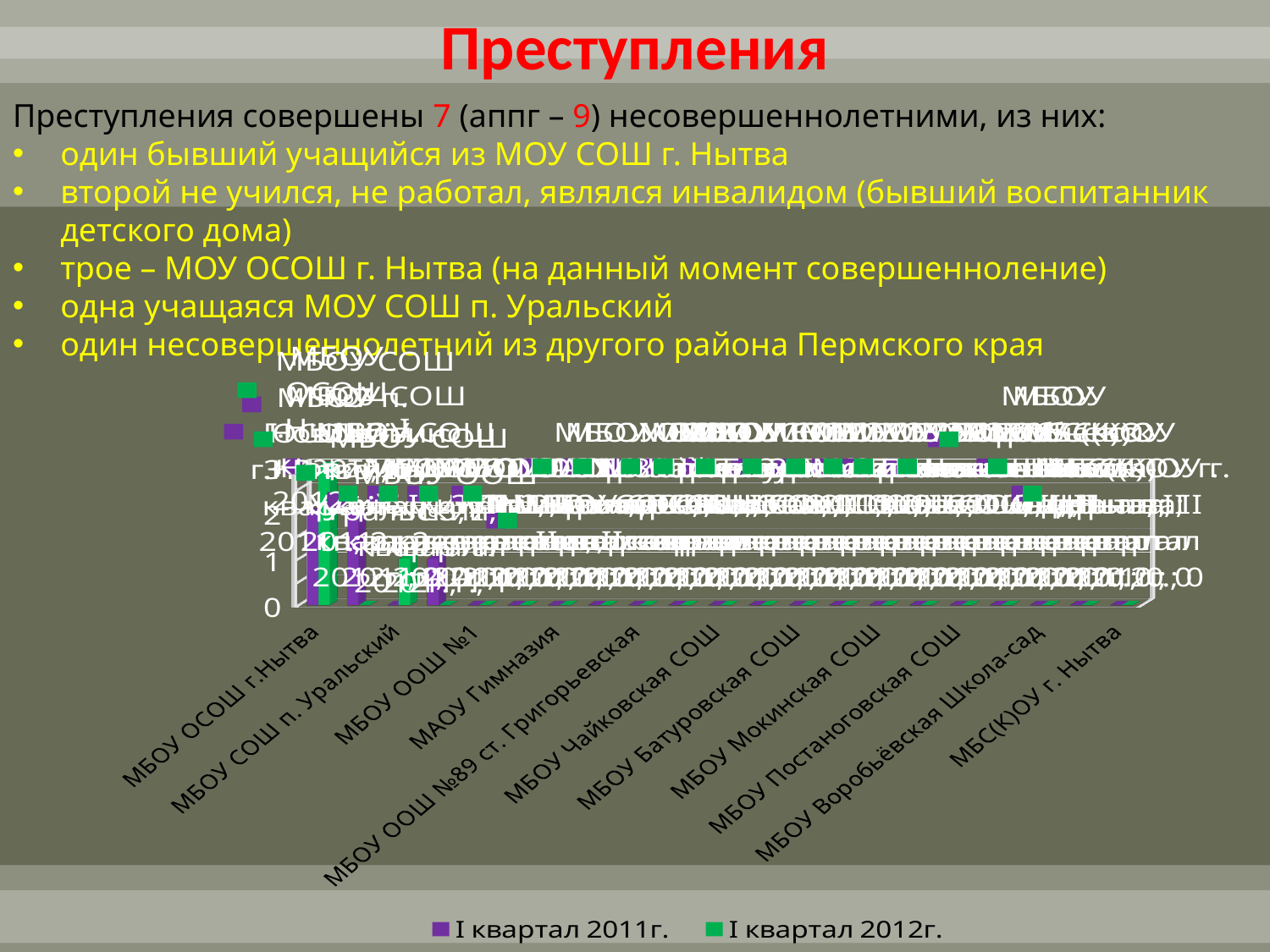
How many series does the chart legend list? 2 What are the two series named in the chart legend? I квартал 2011г. and I квартал 2012г. What kind of chart is shown on the slide? bar chart What is the highest tick value shown on the chart's vertical axis? 3 Which series is drawn in green in the chart? I квартал 2012г. Which category has the tallest bar in the chart? МБОУ ОСОШ г.Нытва